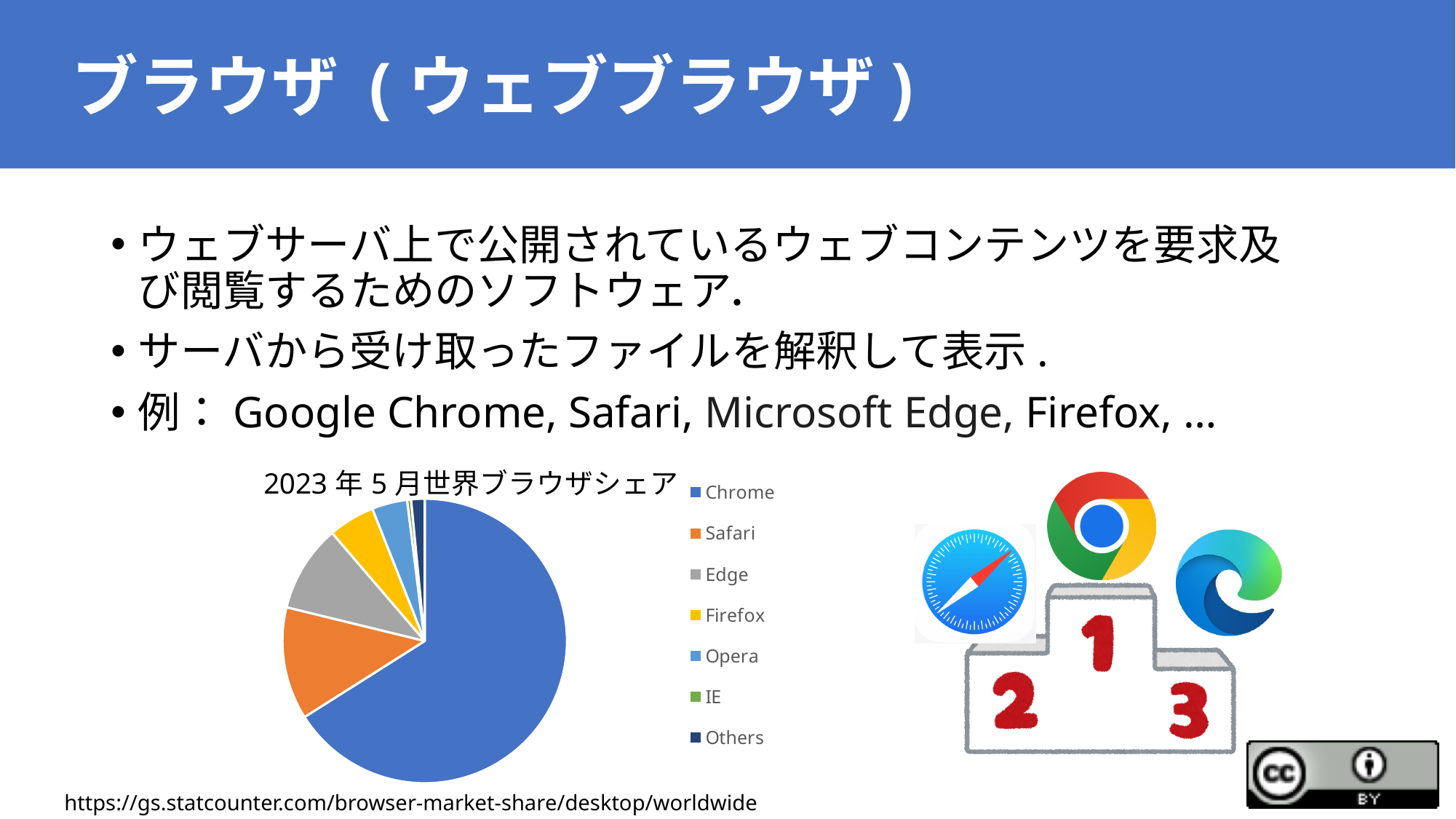
Which slice is larger in the pie chart, Firefox or Opera? Firefox Which slice is larger in the pie chart, Edge or Opera? Edge Which browser is listed second in the pie chart's legend? Safari How many categories does the pie chart's legend list? 7 Which slice is larger in the pie chart, Safari or Edge? Safari What is the title of the pie chart? 2023年5月世界ブラウザシェア What kind of chart is shown on the slide? pie chart What colour is the Chrome slice in the pie chart? blue Which browser has the largest slice in the pie chart? Chrome